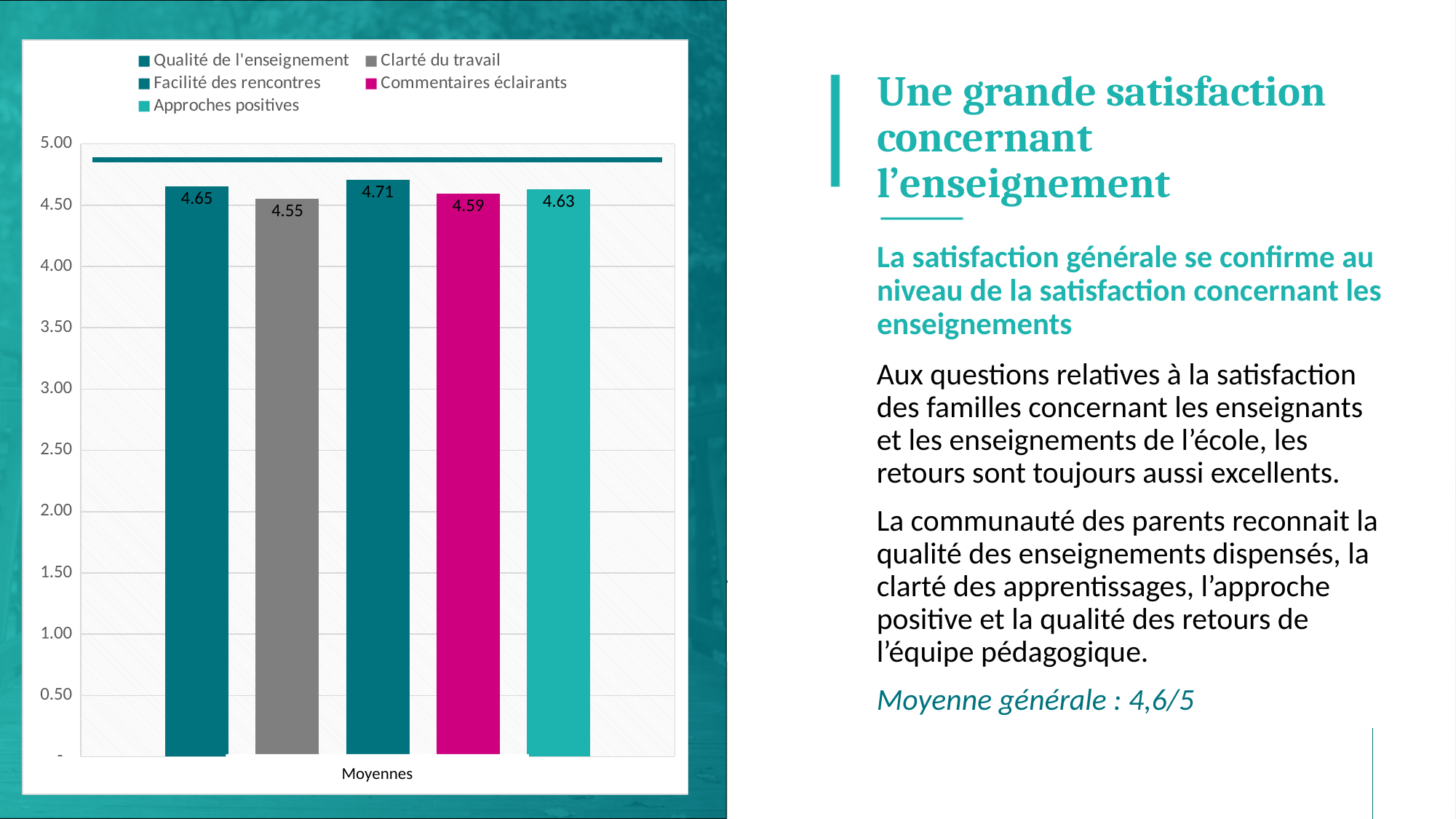
What is the value for Facilité des rencontres? 4.71 What is the value for Clarté du travail? 4.55 What is the value for Commentaires éclairants? 4.59 What is the label on the x axis of the chart? Moyennes Which is larger, the value for Qualité de l'enseignement or the value for Approches positives? Qualité de l'enseignement Which series has the lowest value? Clarté du travail What is the value for Qualité de l'enseignement? 4.65 What is the value for Approches positives? 4.63 What kind of chart is shown on the slide? Bar chart How many series does the legend list? 5 What is the difference between the values for Facilité des rencontres and Clarté du travail? 0.16 Which series has the highest value? Facilité des rencontres